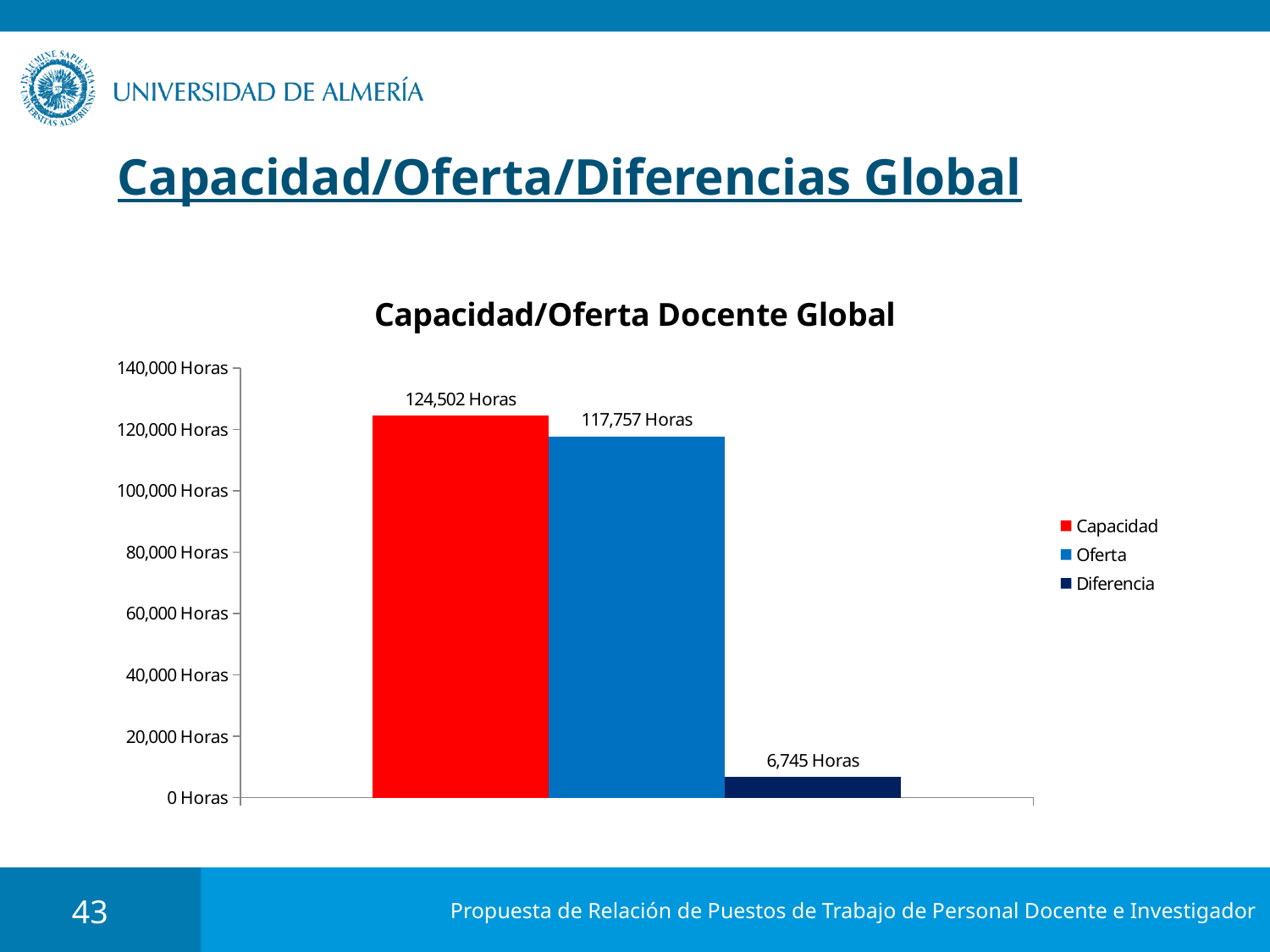
What is the value for Oferta? 117,757 Horas What is the difference between Capacidad and Oferta? 6,745 Horas Is the value for Diferencia greater or less than 20,000 Horas? less How many series does the legend list? 3 What is the value for Capacidad? 124,502 Horas What is the value for Diferencia? 6,745 Horas Which series has the highest value? Capacidad What kind of chart is shown? Bar chart Is the value for Oferta greater or less than 100,000 Horas? greater What is the title of the chart? Capacidad/Oferta Docente Global Which series has the lowest value? Diferencia Which is larger, Capacidad or Oferta? Capacidad